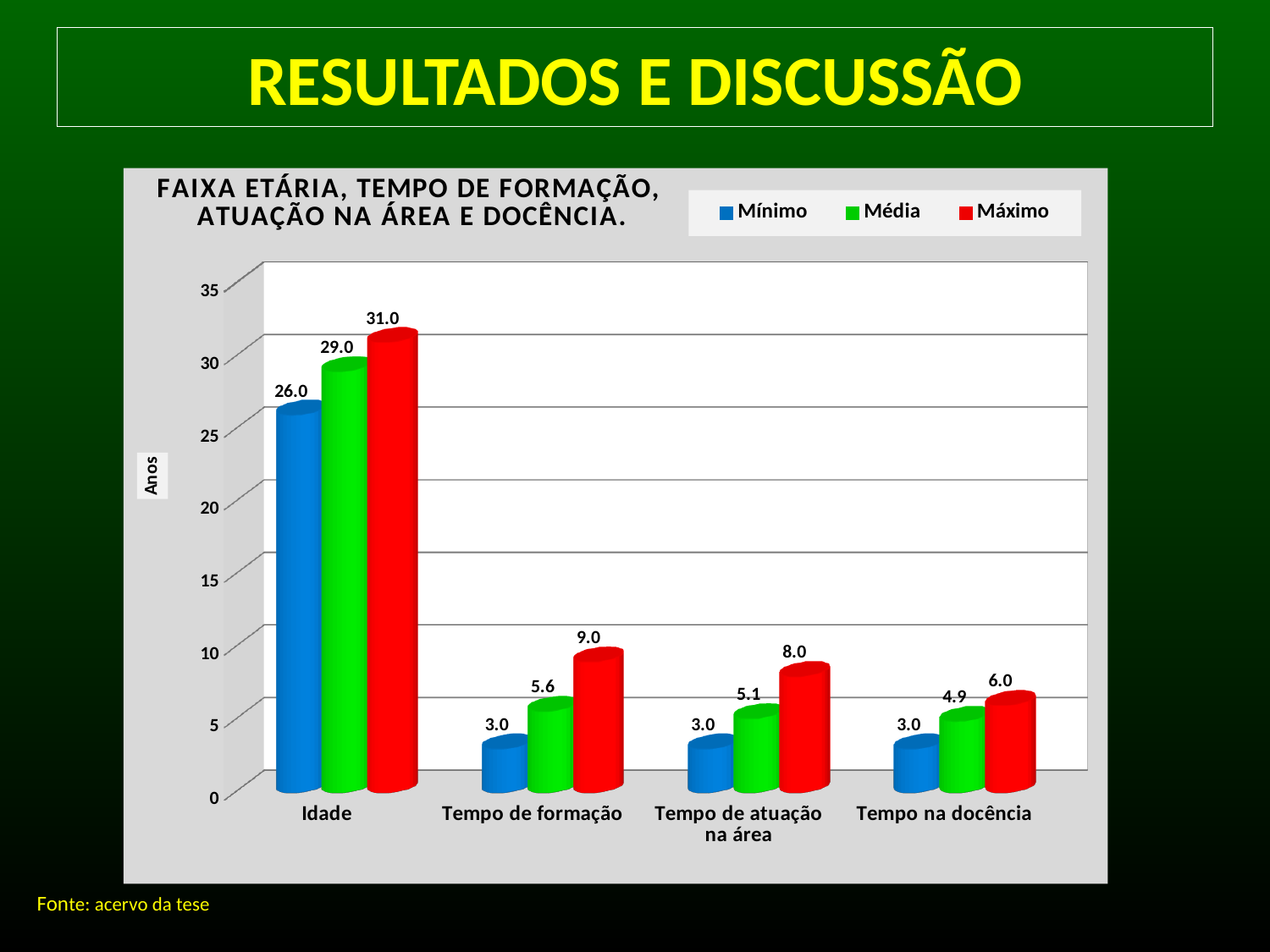
What is the difference between the Máximo and Mínimo values for Idade? 5.0 What is the Máximo value for Idade? 31.0 What kind of chart is shown on the slide? Bar chart How many categories are shown on the x axis? 4 What is the Média value for Tempo de formação? 5.6 Which category has the lowest Máximo value? Tempo na docência What is the difference between the Máximo values for Tempo de formação and Tempo de atuação na área? 1.0 How many series does the legend list? 3 What is the label of the vertical axis? Anos Which category has the highest Média value? Idade What is the Mínimo value for Tempo na docência? 3.0 Which is larger, the Média value for Tempo de atuação na área or the Média value for Tempo na docência? Tempo de atuação na área